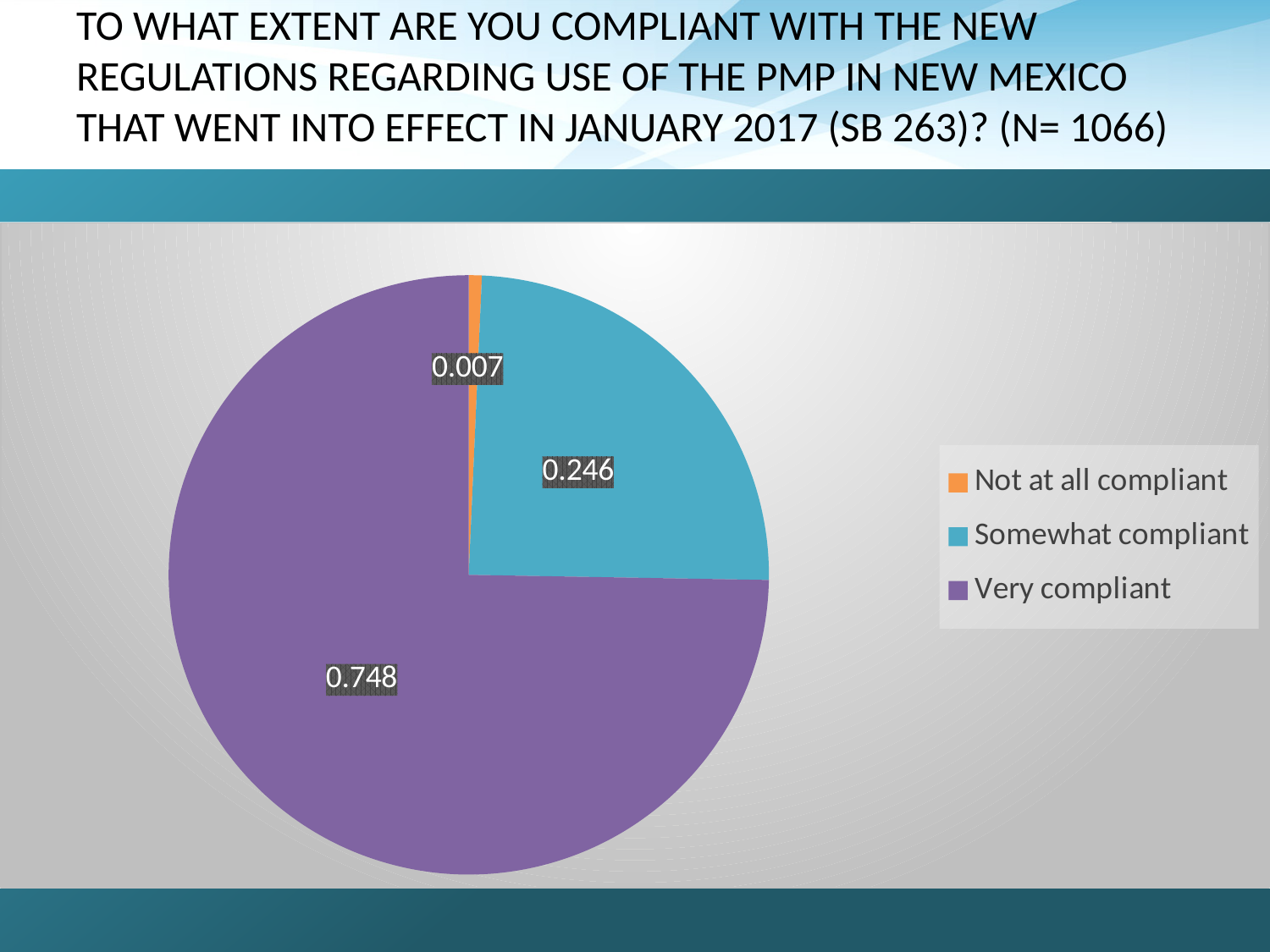
What is the value for Somewhat compliant? 0.246 Which category has the smallest slice? Not at all compliant What is the value for Not at all compliant? 0.007 Which is larger, the value for Somewhat compliant or the value for Not at all compliant? Somewhat compliant What colour is the Somewhat compliant slice? teal How many categories does the legend list? 3 What is the value for Very compliant? 0.748 What is the difference between the values for Very compliant and Somewhat compliant? 0.502 What colour is the Very compliant slice? purple What is the difference between the values for Somewhat compliant and Not at all compliant? 0.239 Which category has the largest slice? Very compliant What kind of chart is shown on the slide? pie chart